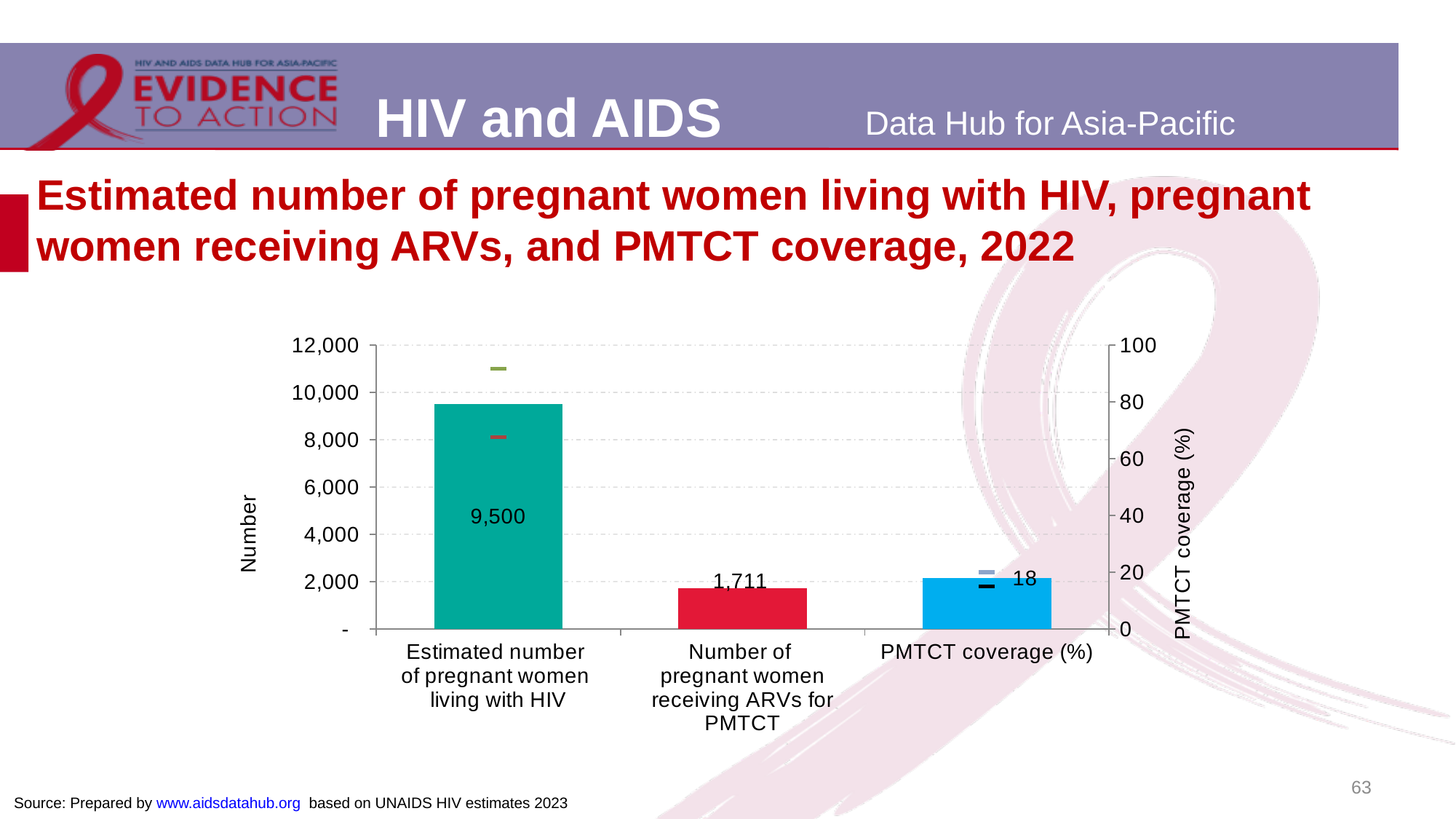
What is the difference between the estimated number of pregnant women living with HIV and the number of pregnant women receiving ARVs for PMTCT? 7,789 What is the PMTCT coverage (%) value shown on the chart? 18 What is the estimated number of pregnant women living with HIV shown on the chart? 9,500 What kind of chart is shown on the slide? Bar chart What is the label of the left-hand vertical axis of the chart? Number Which category has the tallest bar on the chart? Estimated number of pregnant women living with HIV Is the PMTCT coverage (%) value greater or less than 20 on the right-hand axis? less Is the value for the number of pregnant women receiving ARVs for PMTCT greater or less than 2,000? less What is the label of the right-hand vertical axis of the chart? PMTCT coverage (%) How many bars are plotted on the chart? 3 Which is larger: the estimated number of pregnant women living with HIV or the number of pregnant women receiving ARVs for PMTCT? Estimated number of pregnant women living with HIV What is the number of pregnant women receiving ARVs for PMTCT shown on the chart? 1,711